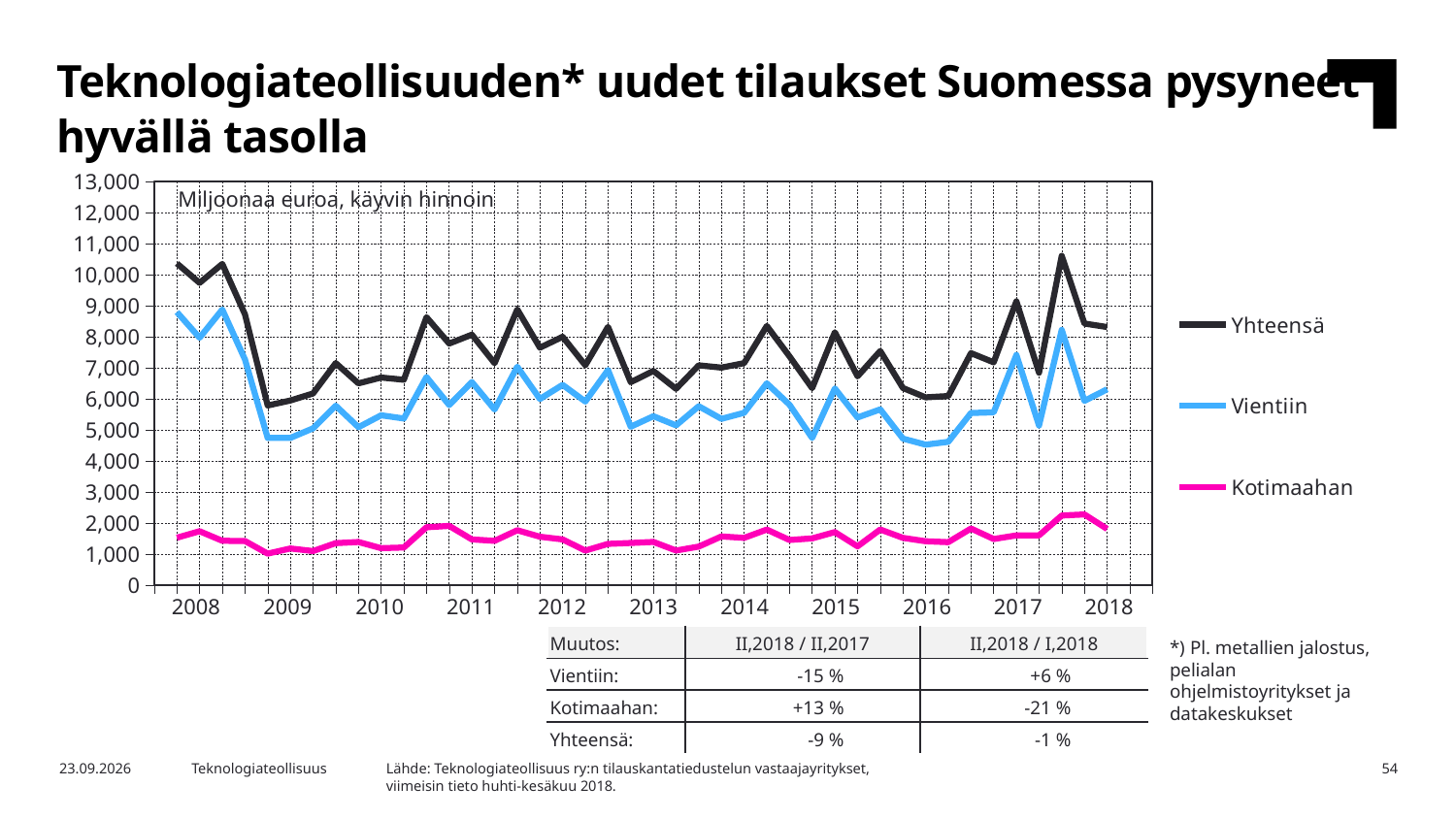
Which series has the lowest values throughout the chart? Kotimaahan What unit is stated in the label inside the chart area? Miljoonaa euroa, käyvin hinnoin Is the value for Vientiin at the start of 2008 greater or less than 7,000? greater What kind of chart is shown on the slide? Line chart How many series does the legend list? 3 Is the value for Yhteensä at the start of 2008 greater or less than 10,000? greater Which series has the highest values throughout the chart? Yhteensä At the start of 2018, which is larger, the value for Vientiin or the value for Kotimaahan? Vientiin Is the value for Kotimaahan at the start of 2008 greater or less than 3,000? less How many year labels are shown on the x axis? 11 Does the Yhteensä line rise or fall between the start of 2008 and the start of 2009? fall Which series are listed in the chart legend? Yhteensä, Vientiin, Kotimaahan